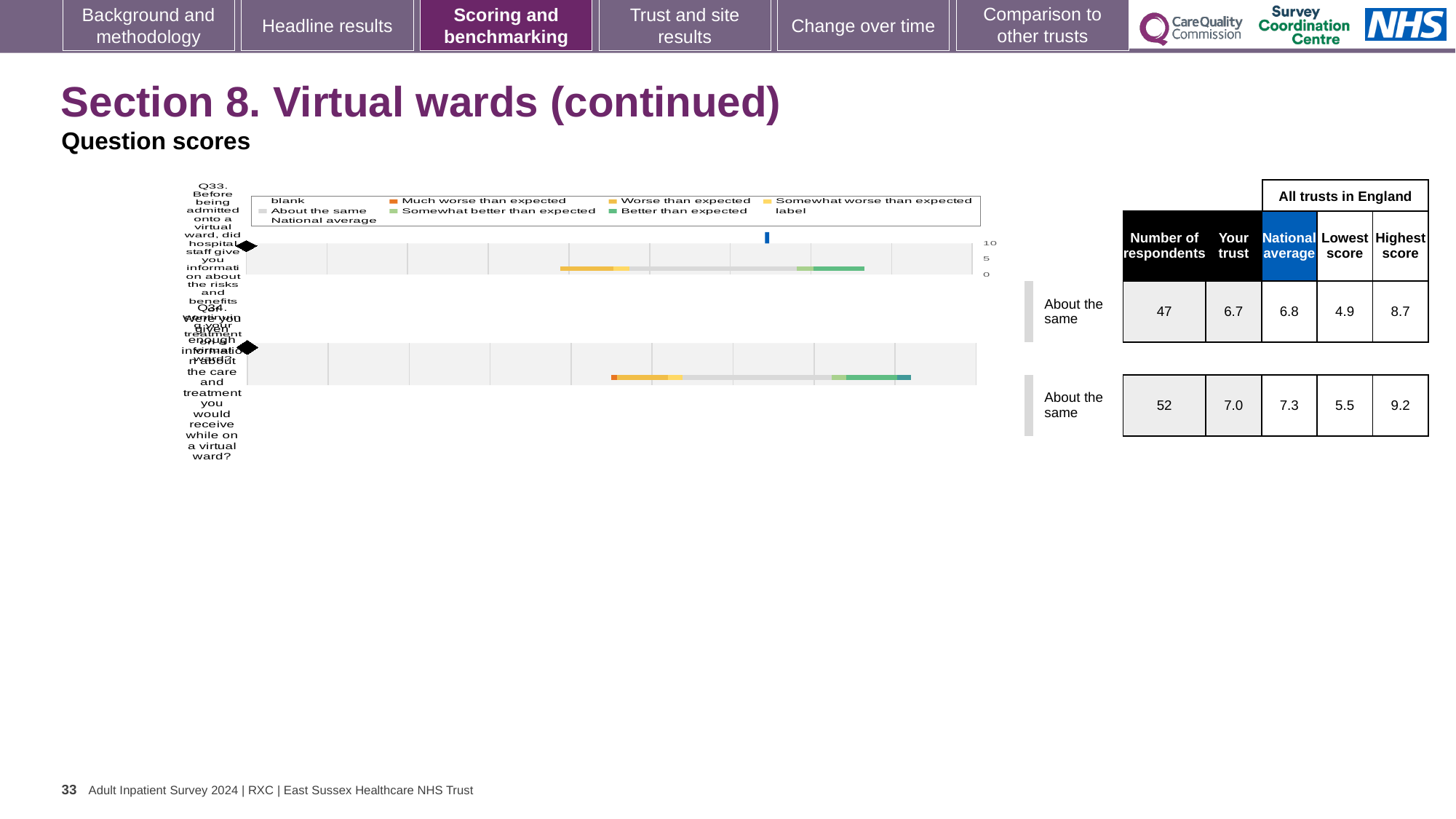
In the table beside the chart, what is the highest score for Q34? 9.2 In the table beside the chart, what is the 'Your trust' score for Q34? 7.0 What benchmark label is shown next to the Q33 bar? About the same For Q34, what is the difference between the highest score and the lowest score? 3.7 What heading appears above the National average, Lowest score and Highest score columns in the table? All trusts in England Which question has the larger number of respondents, Q33 or Q34? Q34 For Q33, which is larger: the 'Your trust' score or the national average? national average In the table beside the chart, what is the number of respondents for Q33? 47 In the table beside the chart, what is the lowest score for Q33? 4.9 What kind of chart is used to show the question scores for Q33 and Q34? bar chart In the table beside the chart, what is the national average for Q33? 6.8 How many questions (categories) are plotted in the chart? 2